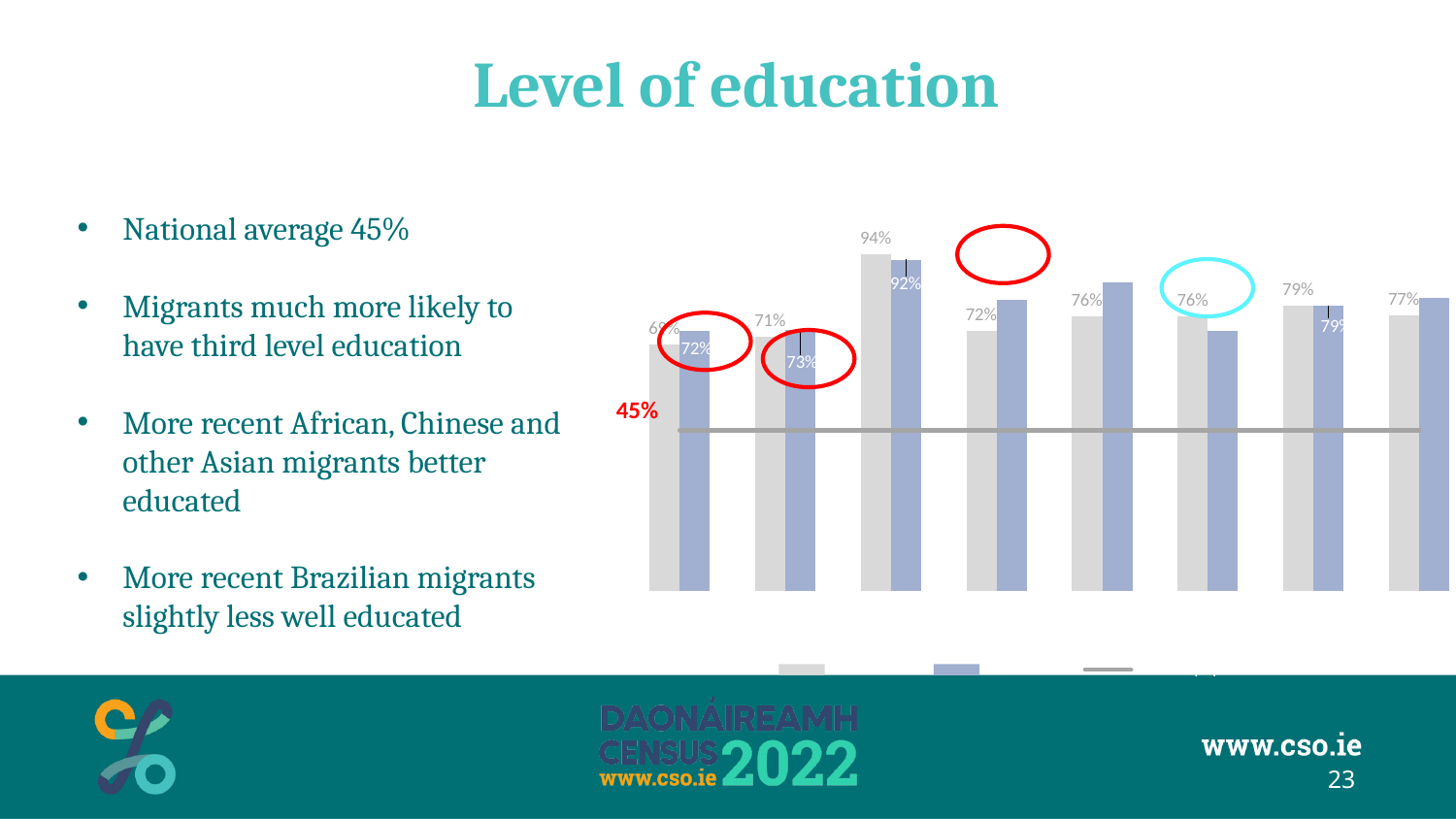
Which group of bars has the highest grey bar? the third group from the left (94%) How many groups of bars are plotted in the chart? 8 What is the value of the blue bar in the second group from the left? 73% What is the value of the blue bar in the third group from the left? 92% Is the value of the grey bar in the rightmost group greater or less than 45%? greater What is the value of the grey bar in the third group from the left? 94% How many bar series (bar colours) are plotted in the chart? 2 What is the difference between the grey bar (94%) and the blue bar (92%) in the third group from the left? 2 percentage points What value does the horizontal reference line in the chart mark? 45% What kind of chart is shown on the slide? bar chart What is the title of the slide containing the chart? Level of education In the second group from the left, which is larger: the grey bar or the blue bar? the blue bar (73%)